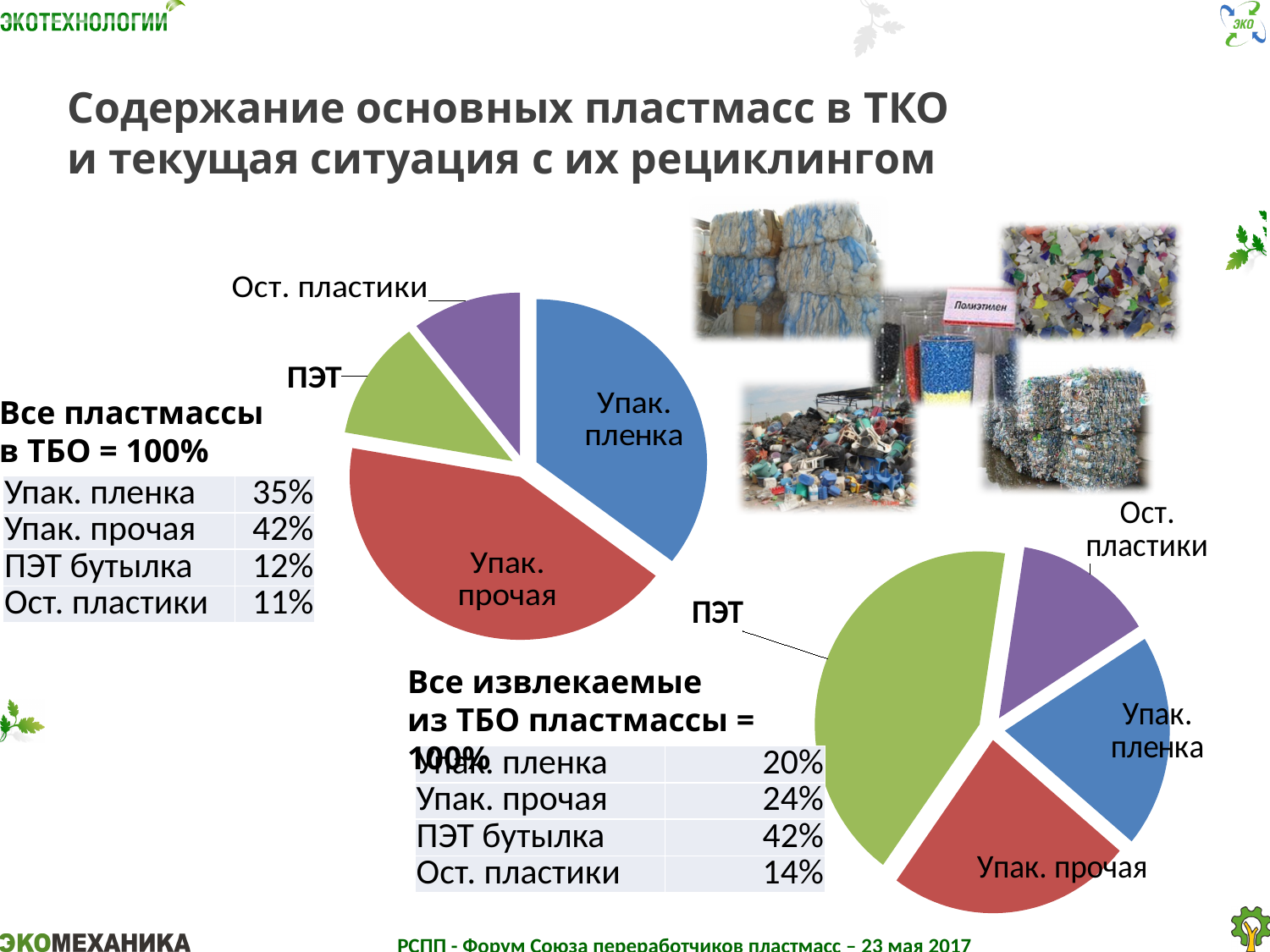
In the upper-left chart (Все пластмассы в ТБО = 100%), what is the difference between Упак. пленка and ПЭТ бутылка? 23% In the lower-right chart (Все извлекаемые из ТБО пластмассы = 100%), what share does Упак. пленка have? 20% In the lower-right chart (Все извлекаемые из ТБО пластмассы = 100%), what share does ПЭТ бутылка have? 42% What kind of chart is the upper-left chart (Все пластмассы в ТБО = 100%)? pie chart In the lower-right chart (Все извлекаемые из ТБО пластмассы = 100%), what is the difference between ПЭТ бутылка and Ост. пластики? 28% How many slices does the upper-left chart (Все пластмассы в ТБО = 100%) have? 4 In the upper-left chart (Все пластмассы в ТБО = 100%), what share does Упак. прочая have? 42% In the upper-left chart (Все пластмассы в ТБО = 100%), what share does Ост. пластики have? 11% In the upper-left chart (Все пластмассы в ТБО = 100%), what colour is the Упак. пленка slice? blue In the lower-right chart (Все извлекаемые из ТБО пластмассы = 100%), which is larger: Упак. прочая or Упак. пленка? Упак. прочая In the upper-left chart (Все пластмассы в ТБО = 100%), which category has the largest share? Упак. прочая In the lower-right chart (Все извлекаемые из ТБО пластмассы = 100%), which category has the smallest share? Ост. пластики